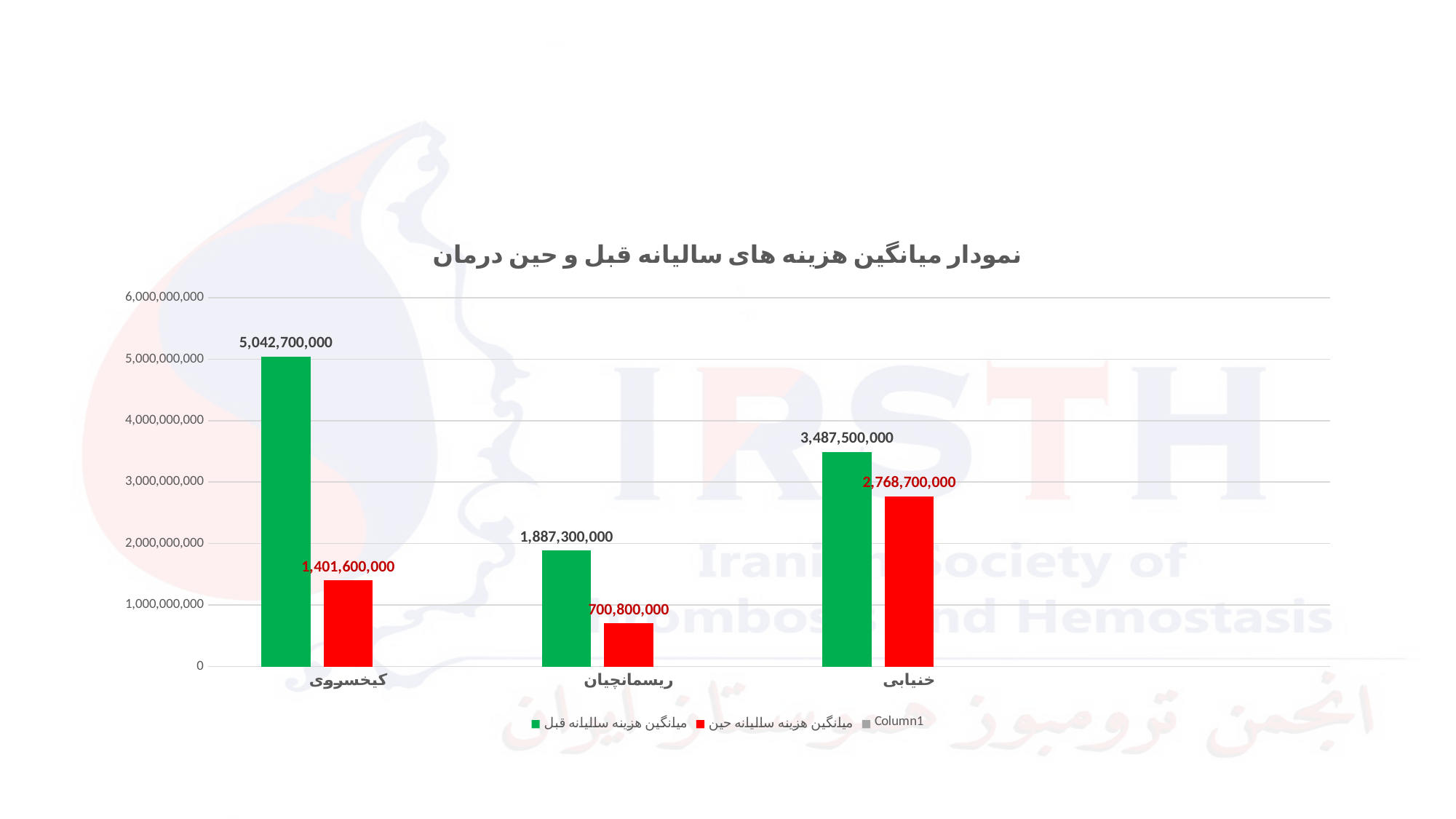
Which is larger: the 'میانگین هزینه سالیانه حین' value for خنیابی or the 'میانگین هزینه سالیانه قبل' value for ریسمانچیان? میانگین هزینه سالیانه حین for خنیابی What is the value of the 'میانگین هزینه سالیانه حین' series for ریسمانچیان? 700,800,000 What kind of chart is shown on the slide? bar chart What is the difference between the 'میانگین هزینه سالیانه قبل' and 'میانگین هزینه سالیانه حین' values for کیخسروی? 3,641,100,000 How many categories are shown on the x axis? 3 What is the value of the 'میانگین هزینه سالیانه قبل' series for کیخسروی? 5,042,700,000 How many series does the legend list? 3 Is the 'میانگین هزینه سالیانه قبل' value for خنیابی greater or less than 3,000,000,000? greater Which category has the lowest value in the 'میانگین هزینه سالیانه حین' series? ریسمانچیان Which category has the highest value in the 'میانگین هزینه سالیانه قبل' series? کیخسروی What is the value of the 'میانگین هزینه سالیانه حین' series for خنیابی? 2,768,700,000 What is the difference between the 'میانگین هزینه سالیانه قبل' and 'میانگین هزینه سالیانه حین' values for خنیابی? 718,800,000